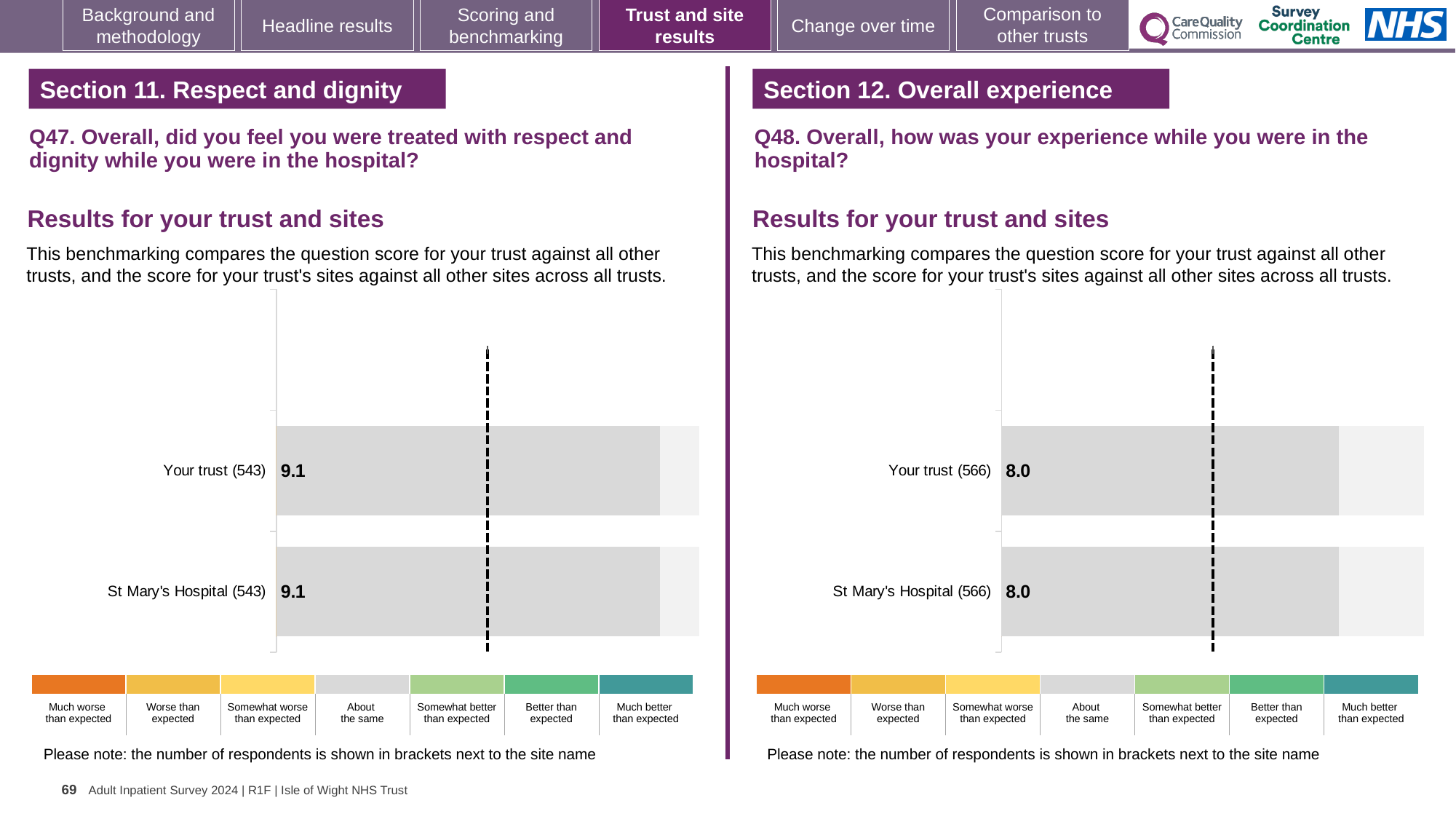
How many bars are plotted in the Q48 chart on the right? 2 In the Q48 chart on the right, what is the score for St Mary's Hospital? 8.0 In the Q47 chart on the left, what is the score for St Mary's Hospital? 9.1 How many bars are plotted in the Q47 chart on the left? 2 In the Q47 chart on the left, what is the difference between the score for Your trust and the score for St Mary's Hospital? 0.0 In the Q48 chart on the right, what is the score for Your trust? 8.0 What kind of chart is used for the Q47 results on the left? Bar chart In the Q48 chart on the right, how many respondents are shown in brackets for St Mary's Hospital? 566 In the Q47 chart on the left, how many respondents are shown in brackets for Your trust? 543 In the Q48 chart on the right, what is the difference between the score for Your trust and the score for St Mary's Hospital? 0.0 In the Q47 chart on the left, what is the score for Your trust? 9.1 Is the score for Your trust in the Q47 chart on the left larger than the score for Your trust in the Q48 chart on the right? Yes